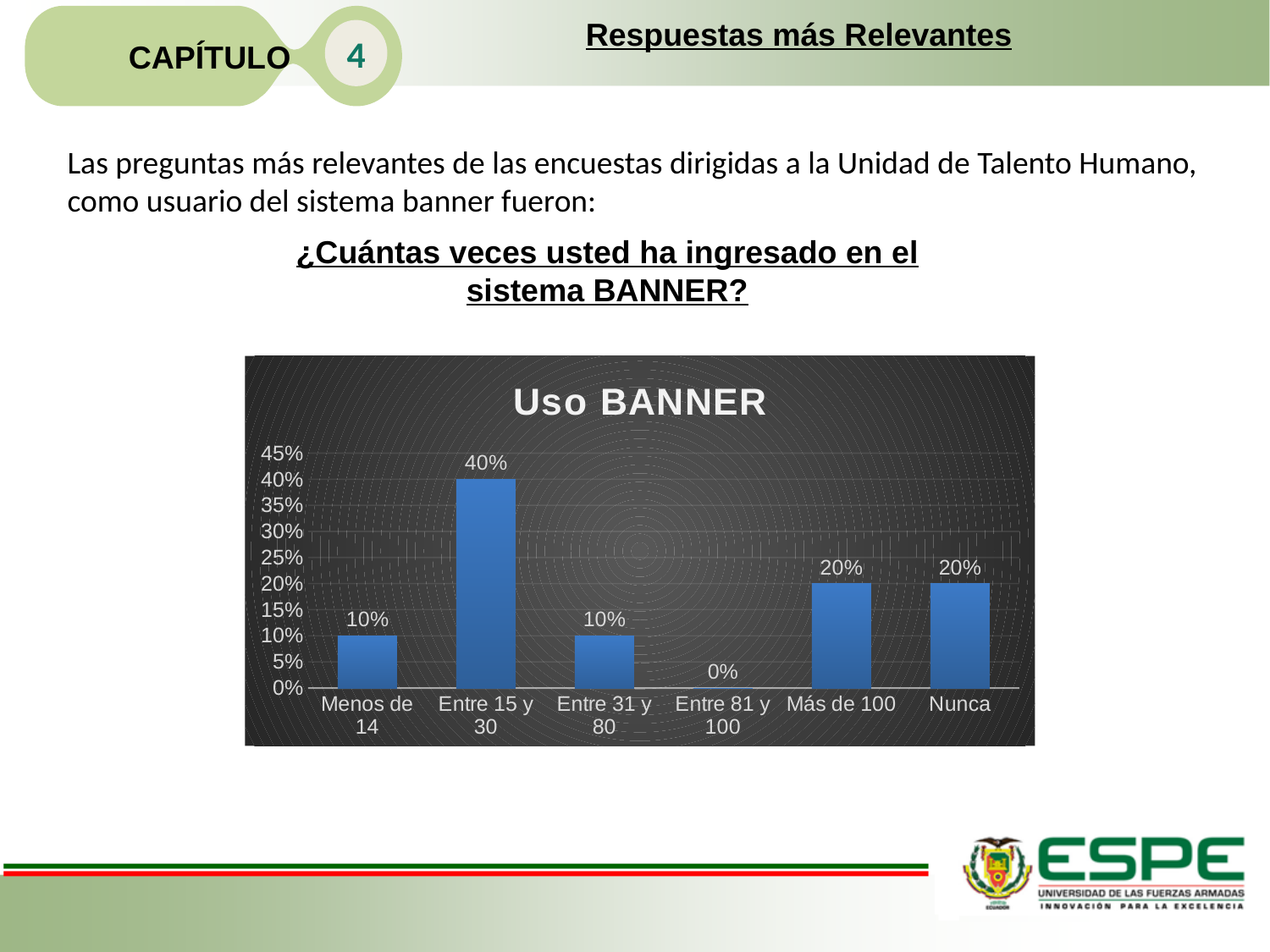
What kind of chart is the Uso BANNER chart? bar chart Which category has the highest value in the Uso BANNER chart? Entre 15 y 30 Which is larger in the Uso BANNER chart: the value for "Entre 31 y 80" or the value for "Más de 100"? Más de 100 What is the value for "Menos de 14" in the Uso BANNER chart? 10% Which category has the lowest value in the Uso BANNER chart? Entre 81 y 100 How many categories are shown on the x axis of the Uso BANNER chart? 6 What is the value for "Entre 81 y 100" in the Uso BANNER chart? 0% What is the value for "Entre 15 y 30" in the Uso BANNER chart? 40% What is the title of the chart on the slide? Uso BANNER Is the value for "Entre 15 y 30" in the Uso BANNER chart greater or less than 35%? greater What is the difference between the values for "Entre 15 y 30" and "Más de 100" in the Uso BANNER chart? 20% What is the value for "Nunca" in the Uso BANNER chart? 20%